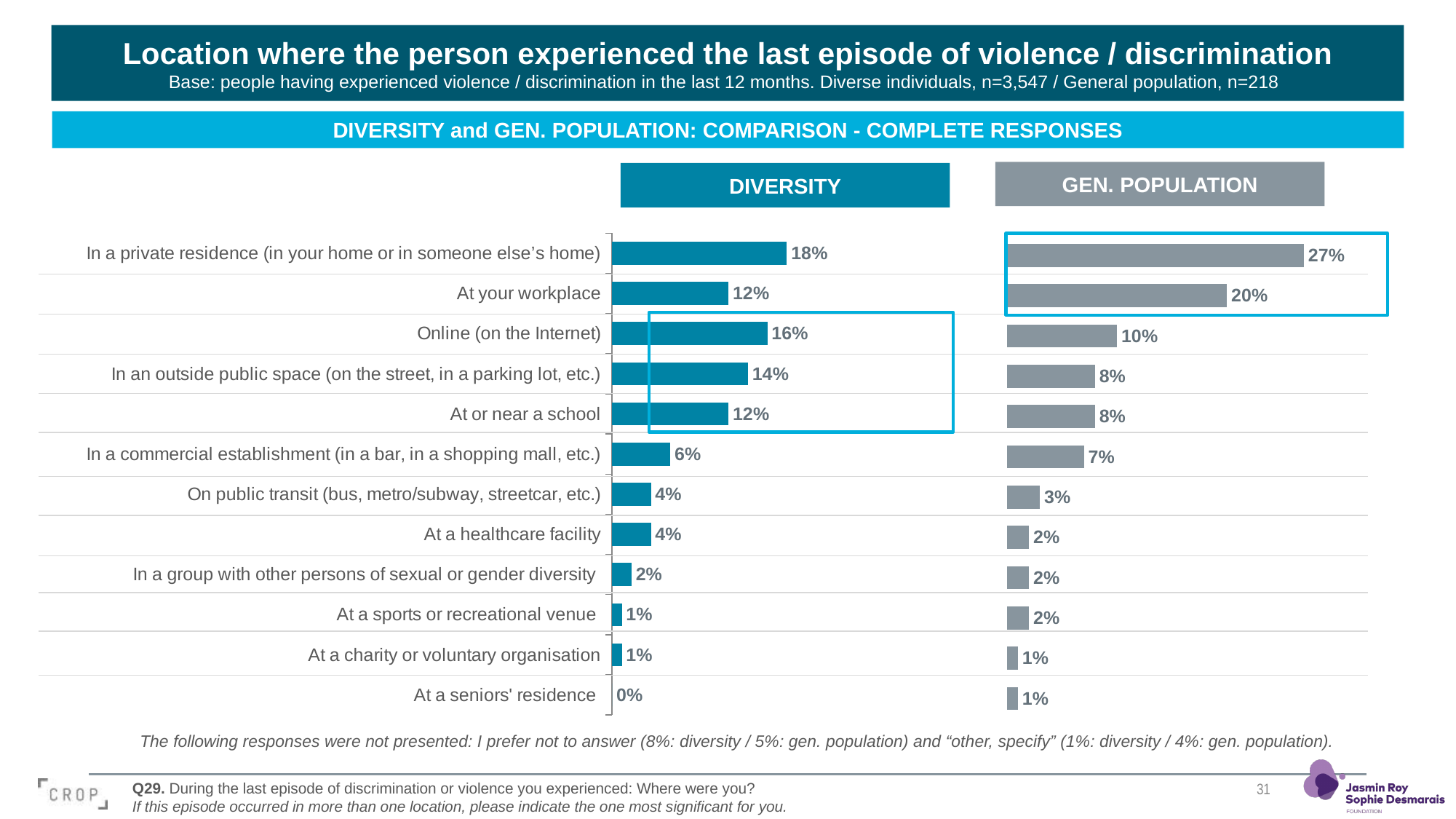
In the DIVERSITY chart, which location has the lowest value? At a seniors' residence In the DIVERSITY chart, what is the value for "Online (on the Internet)"? 16% In the DIVERSITY chart, what is the value for "At a healthcare facility"? 4% In the DIVERSITY chart, what is the difference between "Online (on the Internet)" and "At or near a school"? 4 percentage points How many location categories are shown in the DIVERSITY chart? 12 What type of chart is used to show the DIVERSITY results? bar chart In the GEN. POPULATION chart, which location has the highest value? In a private residence (in your home or in someone else's home) For "In an outside public space", which chart shows the larger value, DIVERSITY or GEN. POPULATION? DIVERSITY In the GEN. POPULATION chart, is the value for "Online (on the Internet)" larger or smaller than the value for "In a commercial establishment"? larger In the GEN. POPULATION chart, what is the value for "At your workplace"? 20% What colour are the bars in the GEN. POPULATION chart? grey What is the difference between the GEN. POPULATION and DIVERSITY values for "In a private residence"? 9 percentage points